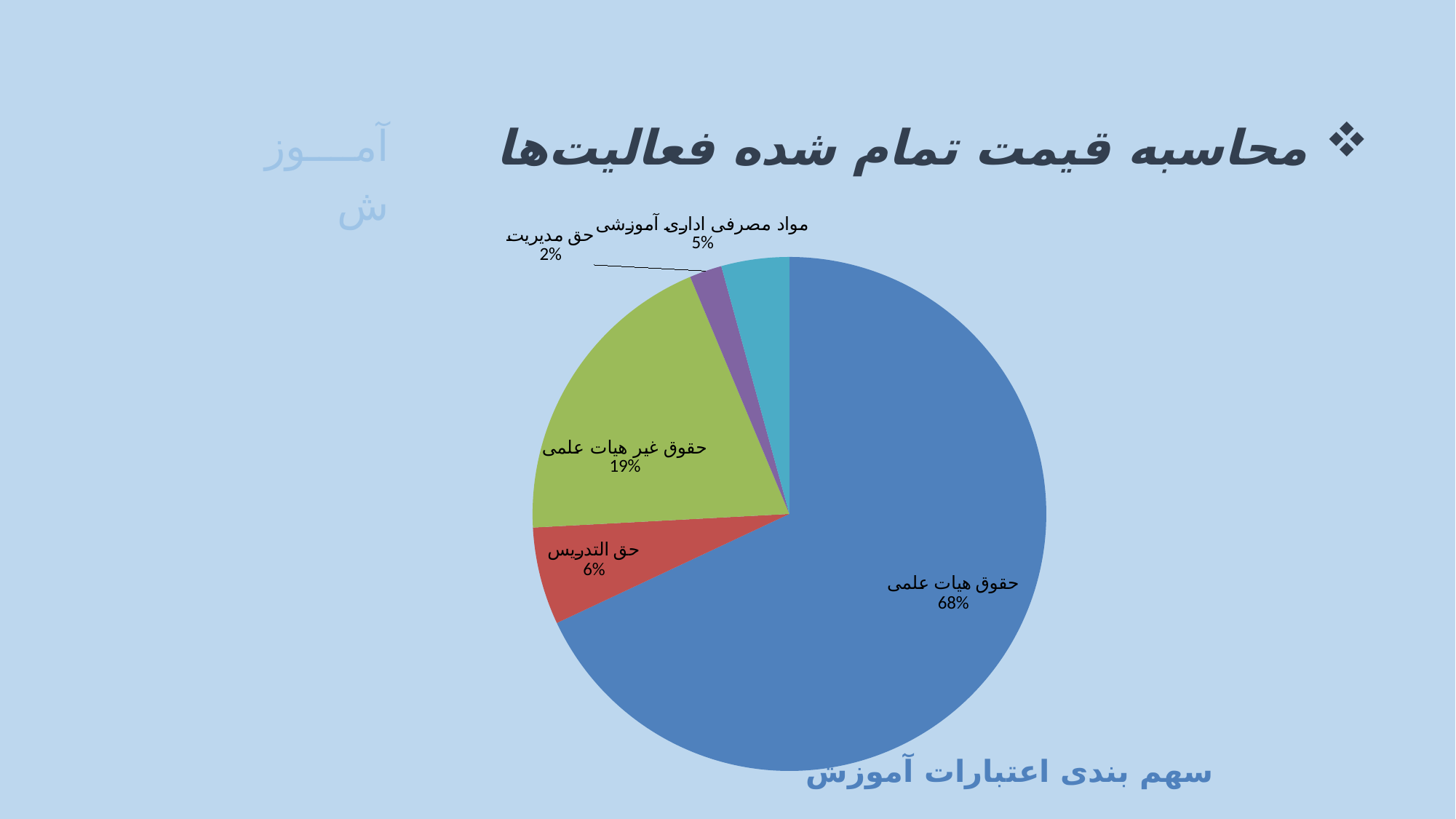
What share of the pie does حقوق غیر هیات علمی have? 19% How many slices does the pie chart have? 5 What kind of chart is shown on the slide? Pie chart What share of the pie does مواد مصرفی اداری آموزشی have? 5% What share of the pie does حق التدریس have? 6% What is the difference in percentage points between حقوق هیات علمی and حقوق غیر هیات علمی? 49 Which category has the largest slice of the pie? حقوق هیات علمی What colour is the slice for حقوق غیر هیات علمی? Green Which category has the smallest slice of the pie? حق مدیریت Which is larger, the share for حق التدریس or the share for مواد مصرفی اداری آموزشی? حق التدریس